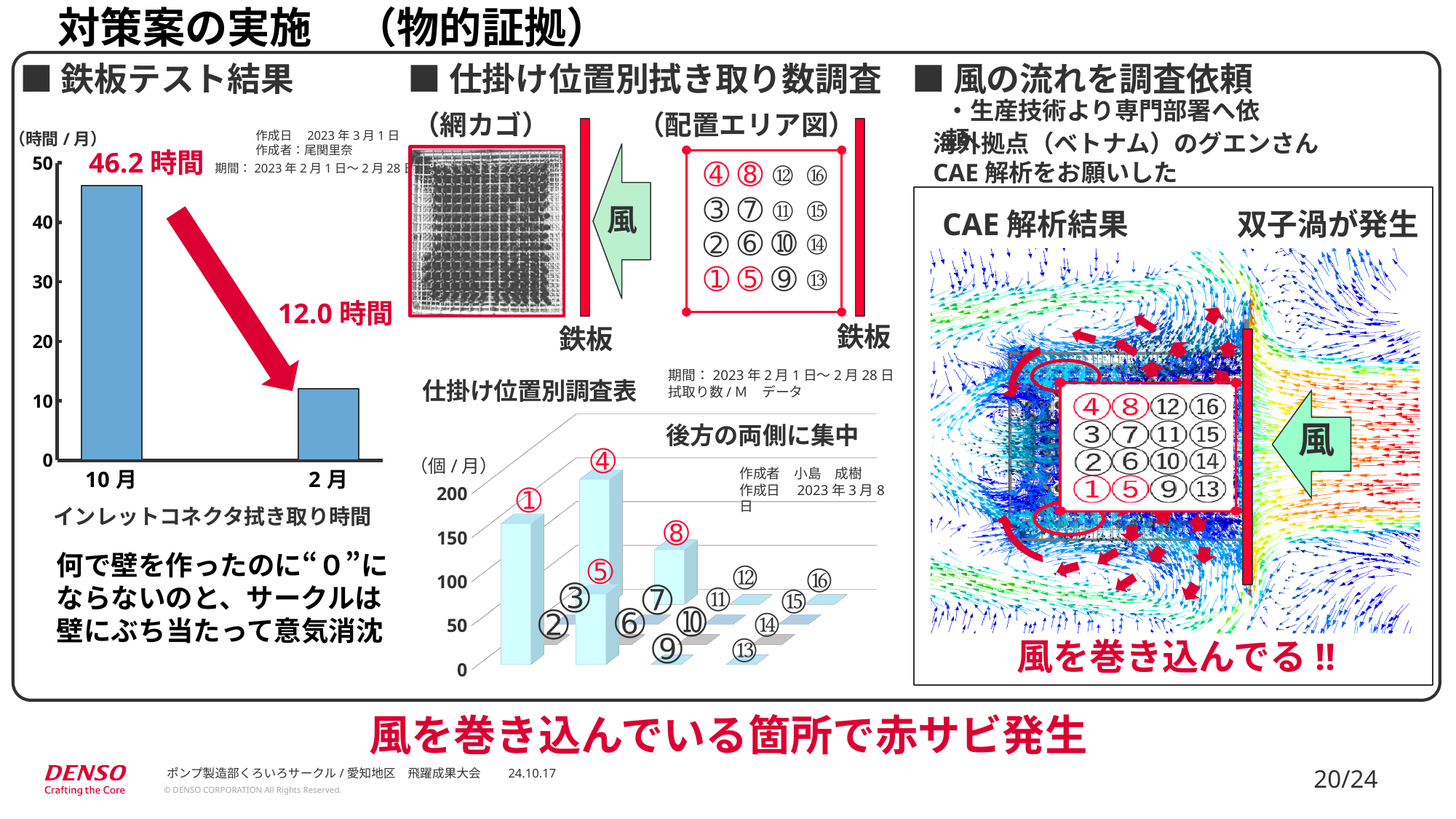
In the bar chart titled インレットコネクタ拭き取り時間, do the values rise or fall from 10月 to 2月? fall In the chart titled 仕掛け位置別調査表, is the value for position ⑧ greater or less than 50? greater What kind of chart is the chart titled インレットコネクタ拭き取り時間? bar chart In the bar chart titled インレットコネクタ拭き取り時間, what is the value for 2月? 12.0 時間 In the bar chart titled インレットコネクタ拭き取り時間, what is the value for 10月? 46.2 時間 In the bar chart titled インレットコネクタ拭き取り時間, what is the difference between the 10月 and 2月 values? 34.2 時間 In the chart titled 仕掛け位置別調査表, is the value for position ① greater or less than 100? greater In the chart titled 仕掛け位置別調査表, which of positions ① and ⑧ has the larger value? ① In the bar chart titled インレットコネクタ拭き取り時間, which month has the higher value, 10月 or 2月? 10月 In the bar chart titled インレットコネクタ拭き取り時間, what unit is shown on the vertical axis? 時間 / 月 In the bar chart titled インレットコネクタ拭き取り時間, how many bars are plotted? 2